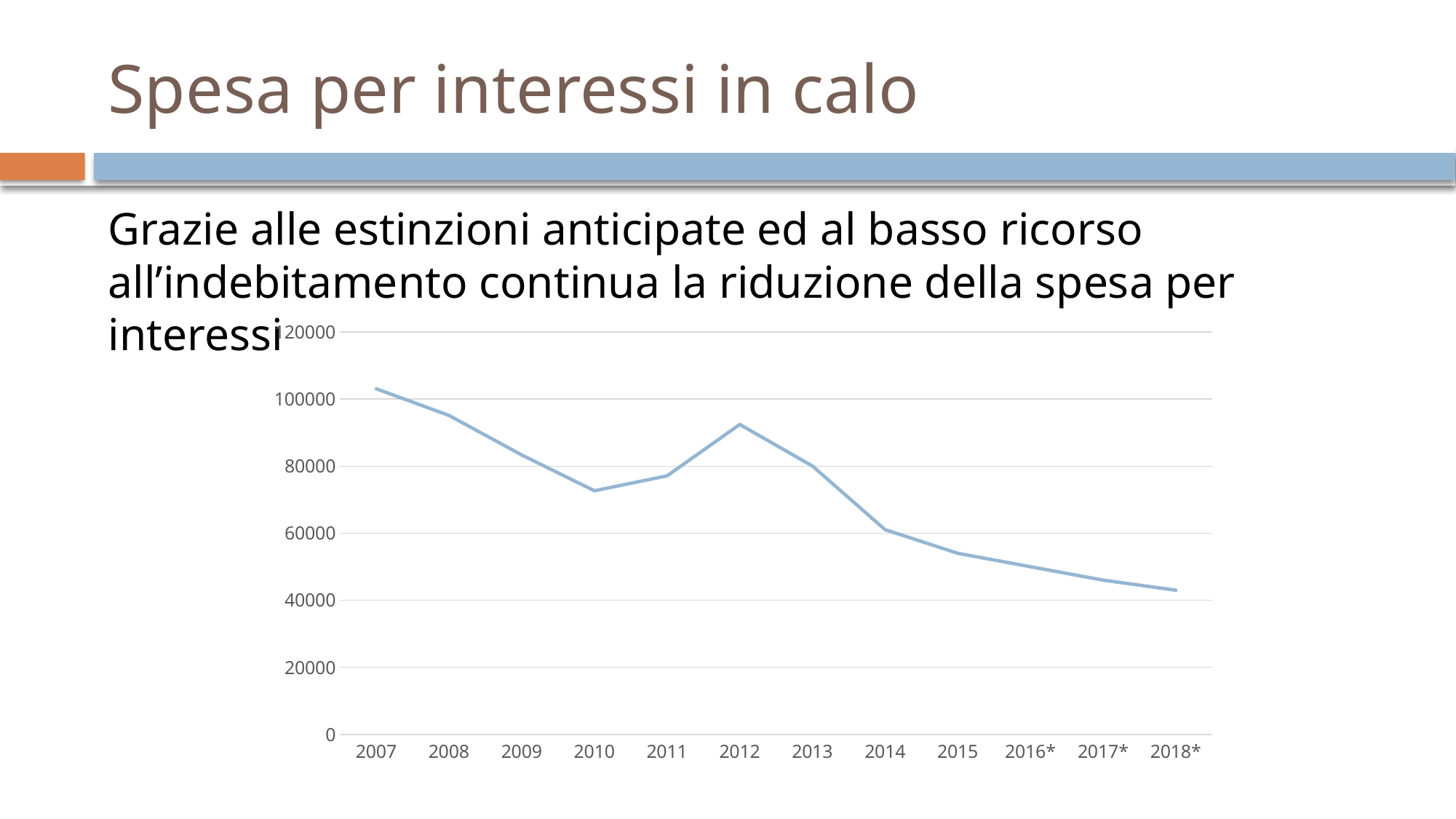
How many years are plotted along the x axis of the chart? 12 Is the value for 2007 greater or less than 100000? greater Is the value for 2012 greater or less than 80000? greater Is the value for 2015 greater or less than 60000? less Overall, do the values rise or fall from 2007 to 2018*? fall What kind of chart is shown on the slide? line chart Which year has the lowest value in the chart? 2018* Which year has the highest value in the chart? 2007 How many of the years on the x axis are marked with an asterisk? 3 Which is larger, the value for 2012 or the value for 2010? 2012